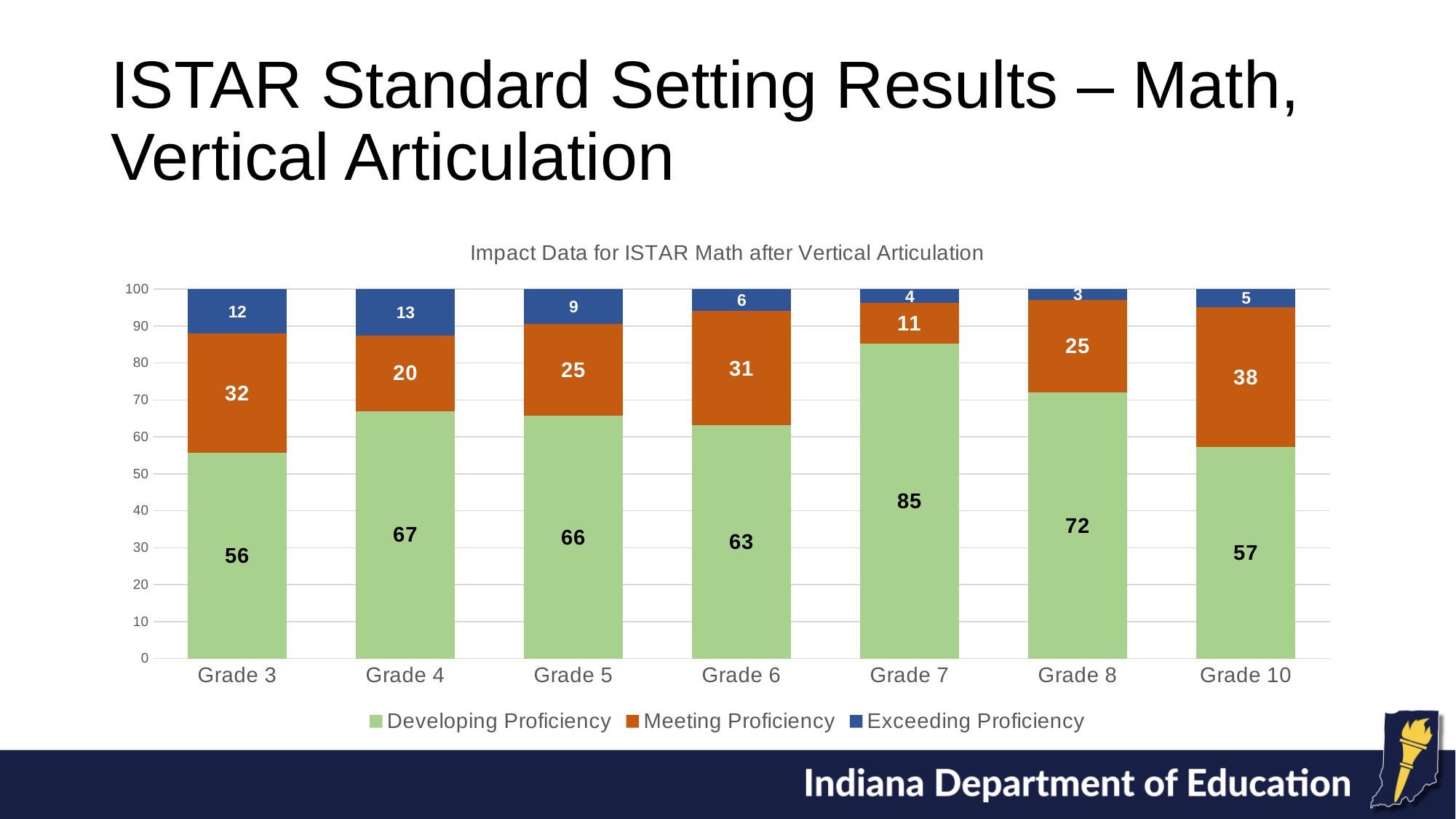
What is the difference between the Meeting Proficiency values for Grade 3 and Grade 4? 12 How many grades are shown on the x axis? 7 What is the Exceeding Proficiency value for Grade 4? 13 What is the Developing Proficiency value for Grade 7? 85 What is the total of the stacked bar for Grade 5? 100 Which grade has the highest Developing Proficiency value? Grade 7 What kind of chart is shown? Stacked bar chart Which is larger, the Developing Proficiency value for Grade 8 or for Grade 6? Grade 8 Which grade has the lowest Exceeding Proficiency value? Grade 8 Which grade has the highest Meeting Proficiency value? Grade 10 What is the Meeting Proficiency value for Grade 10? 38 How many series does the legend list? 3